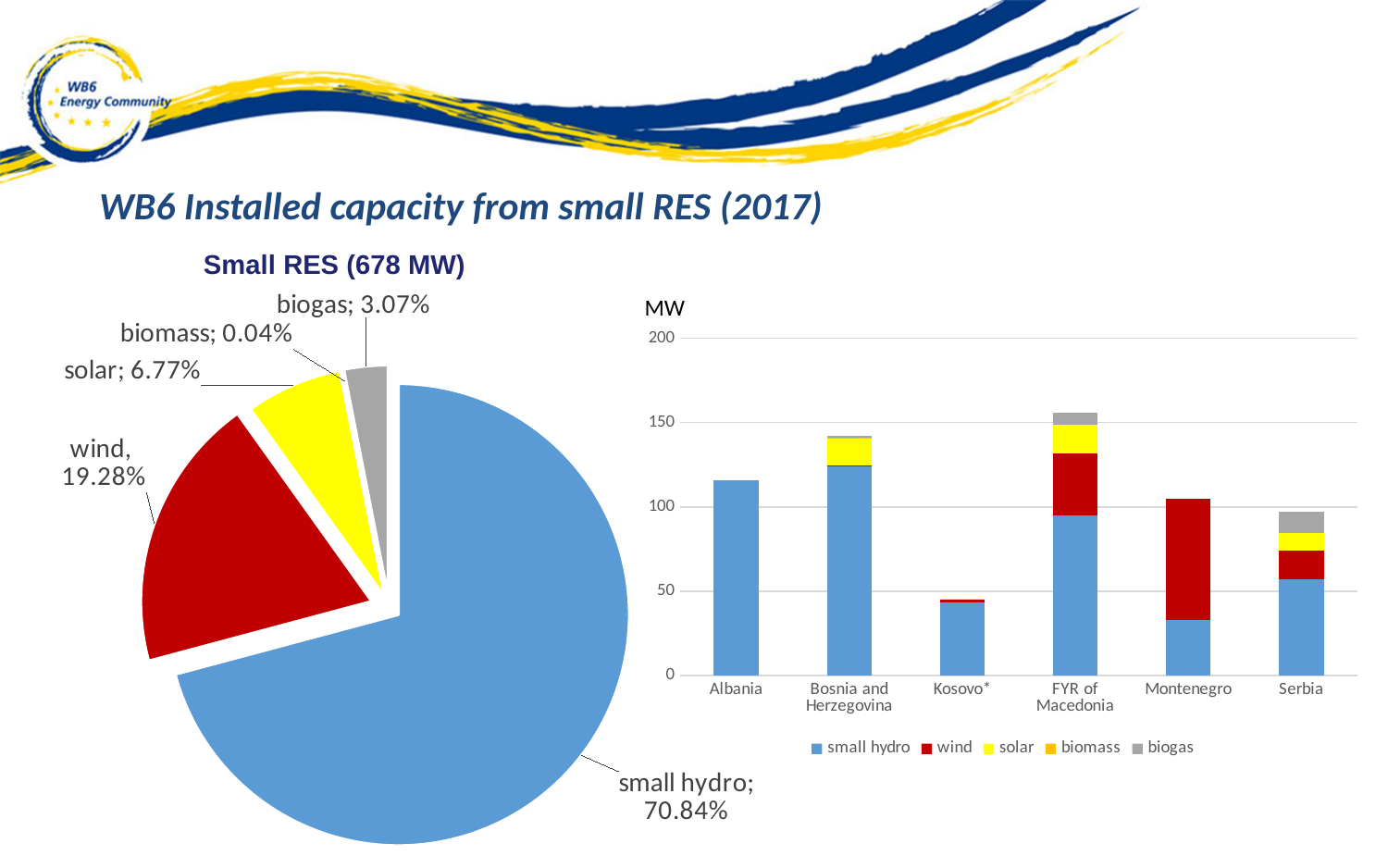
In the bar chart on the right, which country has the highest total installed capacity? FYR of Macedonia In the bar chart on the right, is the total value for Albania greater or less than 100? greater In the bar chart on the right, how many series does the legend list? 5 In the pie chart titled 'Small RES (678 MW)', what share does small hydro have? 70.84% What kind of chart is the chart on the right side of the slide? bar chart In the pie chart titled 'Small RES (678 MW)', what is the difference in percentage points between the biogas share and the solar share? 3.70 In the pie chart titled 'Small RES (678 MW)', what is the share for solar? 6.77% In the pie chart titled 'Small RES (678 MW)', how many slices are shown? 5 In the bar chart on the right, which country has the lowest total installed capacity? Kosovo* In the pie chart titled 'Small RES (678 MW)', what share does wind have? 19.28% In the pie chart titled 'Small RES (678 MW)', which source has the smallest share? biomass In the bar chart on the right, which has the larger wind segment, Montenegro or Serbia? Montenegro